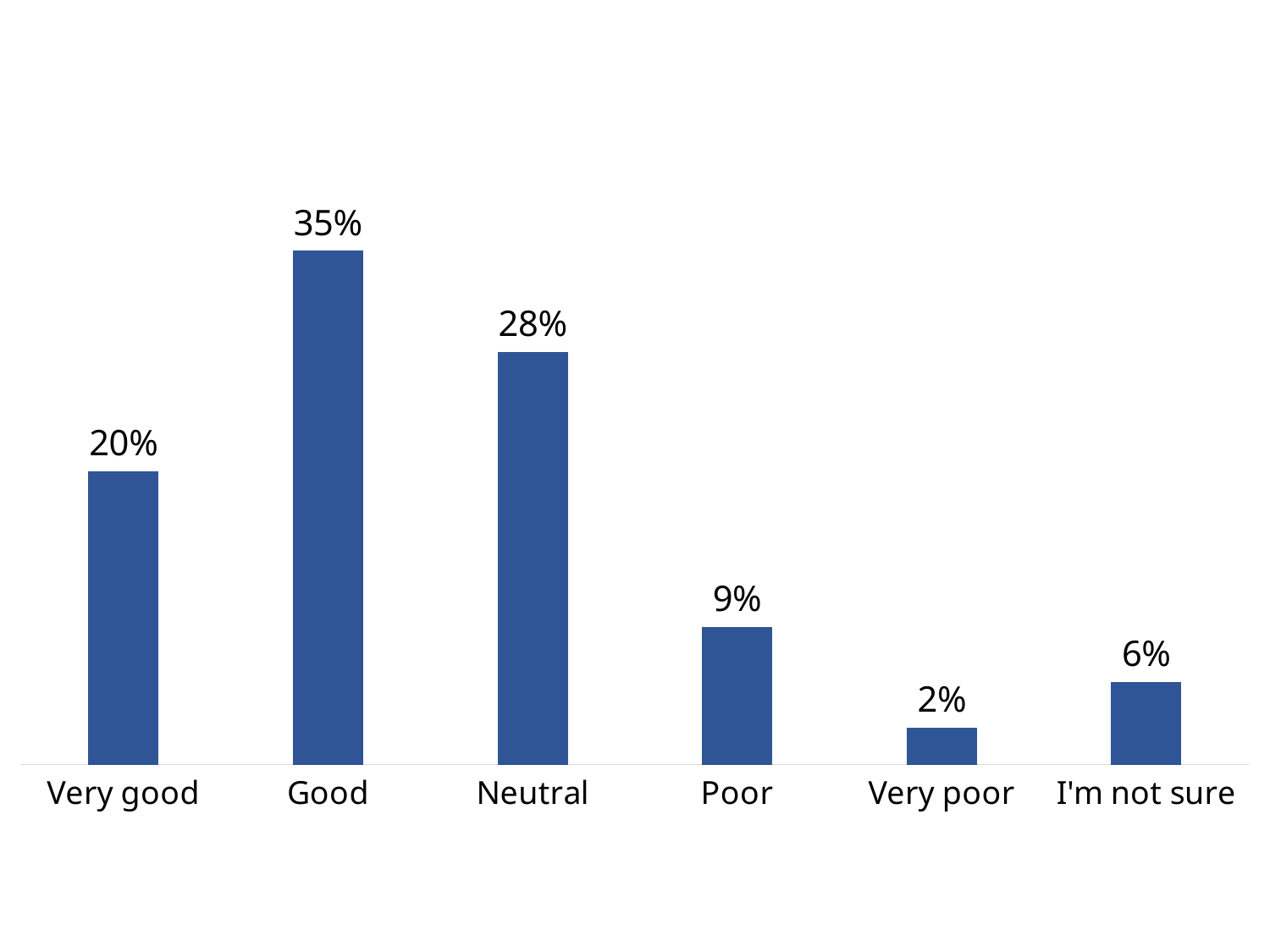
What is the difference between the values for Very good and Poor? 11% Which category has the lowest value? Very poor What is the value for Good? 35% How many categories are shown on the x axis? 6 What is the difference between the values for Good and Neutral? 7% Which category has the highest value? Good What is the value for I'm not sure? 6% What colour are the bars in the chart? Blue Which is larger, the value for Very good or the value for Neutral? Neutral What is the value for Neutral? 28% What kind of chart is shown on the slide? Bar chart What is the value for Very poor? 2%